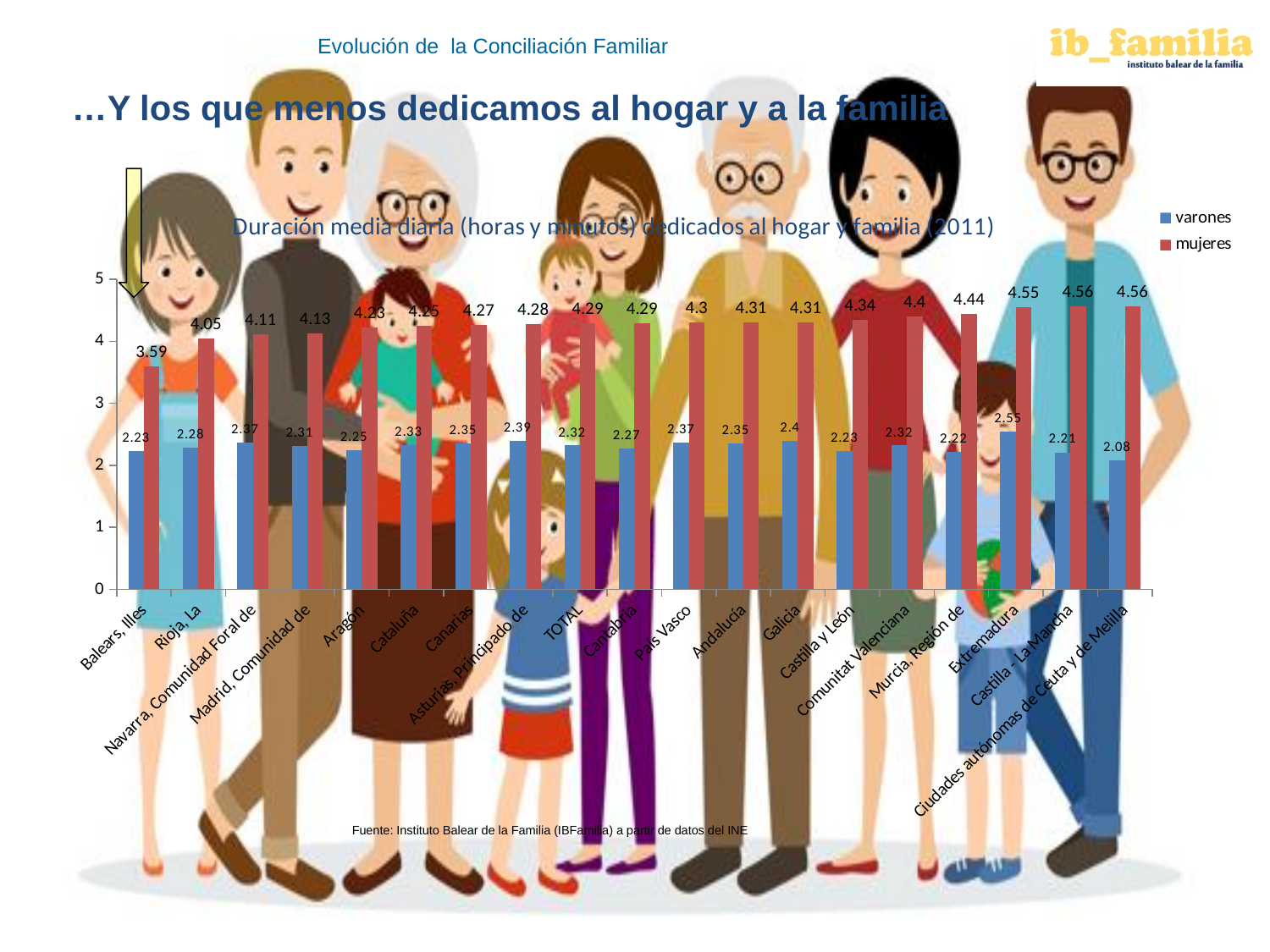
Which category has the lowest value for varones? Ciudades autónomas de Ceuta y de Melilla How many series does the legend list? 2 For mujeres, which is larger: Murcia, Región de or Cantabria? Murcia, Región de How many categories are shown on the x axis? 19 Which category has the lowest value for mujeres? Balears, Illes Which category has the highest value for varones? Extremadura What is the value for mujeres in the TOTAL category? 4.29 Is the value for mujeres in Aragón greater or less than 4? greater What is the value for varones in Extremadura? 2.55 What is the value for mujeres in Balears, Illes? 3.59 What is the value for varones in Ciudades autónomas de Ceuta y de Melilla? 2.08 What kind of chart is shown on the slide? bar chart